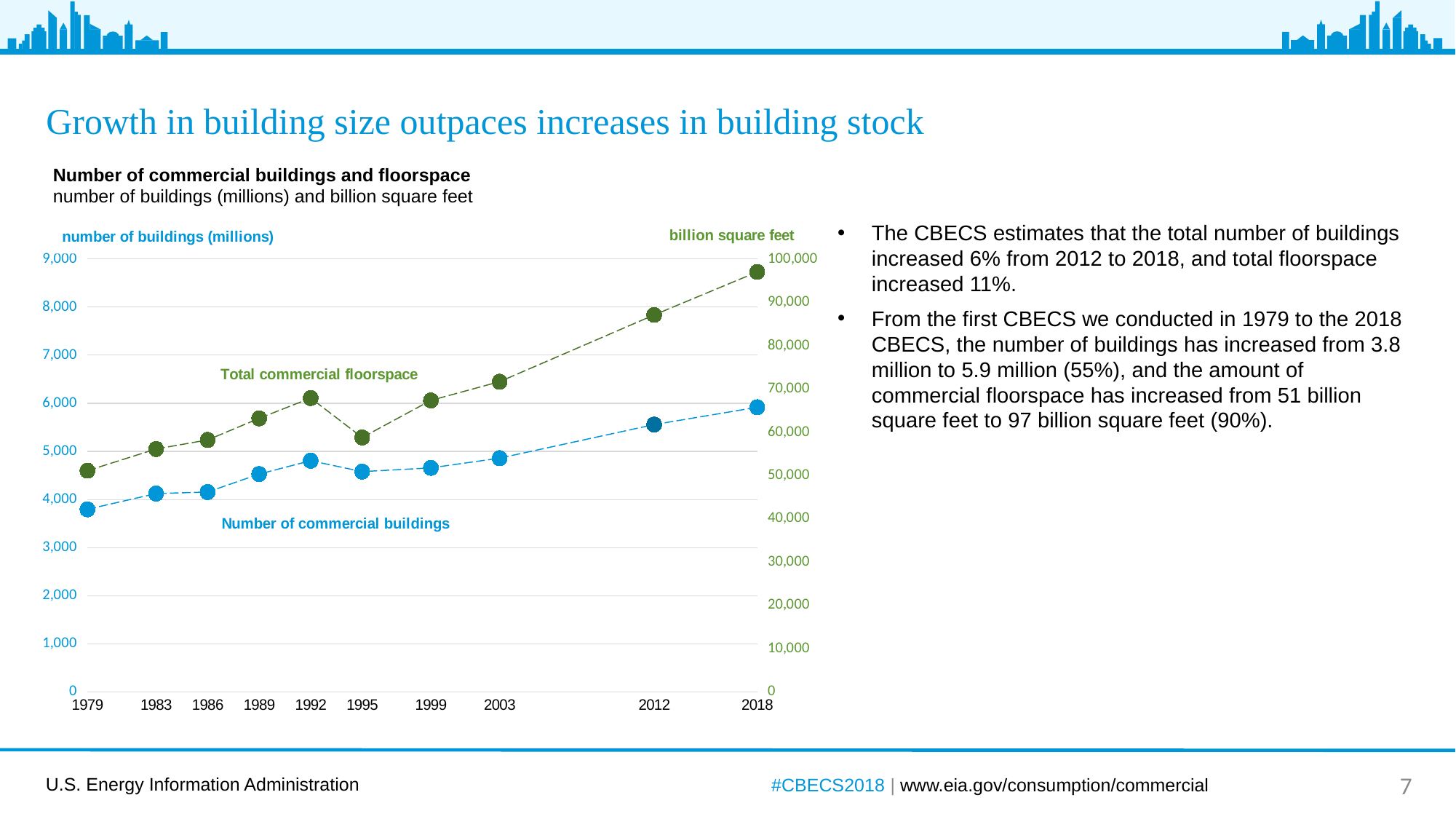
Between 1992 and 1995, did Total commercial floorspace rise or fall? fall In which year is Total commercial floorspace highest? 2018 In which year is the Number of commercial buildings lowest? 1979 What is the label of the right-hand vertical axis of the chart? billion square feet How many data series does the chart show? 2 Is the Total commercial floorspace in 2018 greater or less than 90,000? greater What kind of chart is shown on the slide? line chart Is the Number of commercial buildings in 2012 greater or less than 5,000? greater Is the Total commercial floorspace in 1992 greater or less than 70,000? less Which is larger for Total commercial floorspace: the value in 2003 or the value in 2012? 2012 How many years are plotted along the x axis of the chart? 10